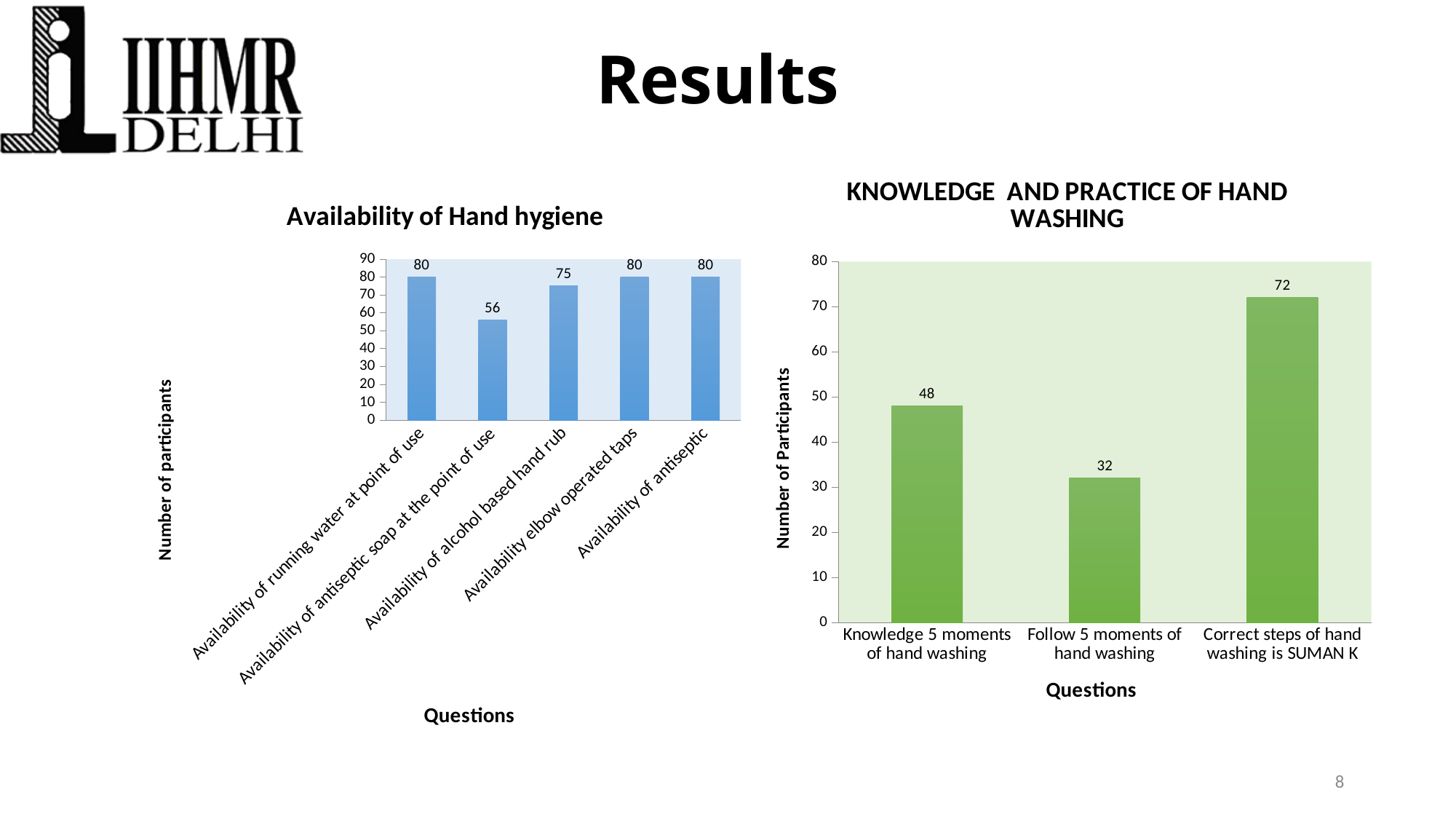
In the 'KNOWLEDGE AND PRACTICE OF HAND WASHING' chart, which category has the highest value? Correct steps of hand washing is SUMAN K In the 'Availability of Hand hygiene' chart, what is the value for 'Availability of alcohol based hand rub'? 75 In the 'Availability of Hand hygiene' chart, what is the value for 'Availability of antiseptic soap at the point of use'? 56 In the 'Availability of Hand hygiene' chart, is the value for 'Availability of alcohol based hand rub' greater or less than 'Availability elbow operated taps'? less In the 'Availability of Hand hygiene' chart, how many categories are plotted? 5 In the 'KNOWLEDGE AND PRACTICE OF HAND WASHING' chart, what is the value for 'Follow 5 moments of hand washing'? 32 In the 'KNOWLEDGE AND PRACTICE OF HAND WASHING' chart, what is the difference between 'Correct steps of hand washing is SUMAN K' and 'Knowledge 5 moments of hand washing'? 24 What is the y-axis label of the 'KNOWLEDGE AND PRACTICE OF HAND WASHING' chart? Number of Participants In the 'KNOWLEDGE AND PRACTICE OF HAND WASHING' chart, how many categories are plotted? 3 In the 'Availability of Hand hygiene' chart, which category has the lowest value? Availability of antiseptic soap at the point of use What kind of chart is the 'KNOWLEDGE AND PRACTICE OF HAND WASHING' chart? bar chart In the 'Availability of Hand hygiene' chart, what is the difference between the value for 'Availability of running water at point of use' and 'Availability of antiseptic soap at the point of use'? 24